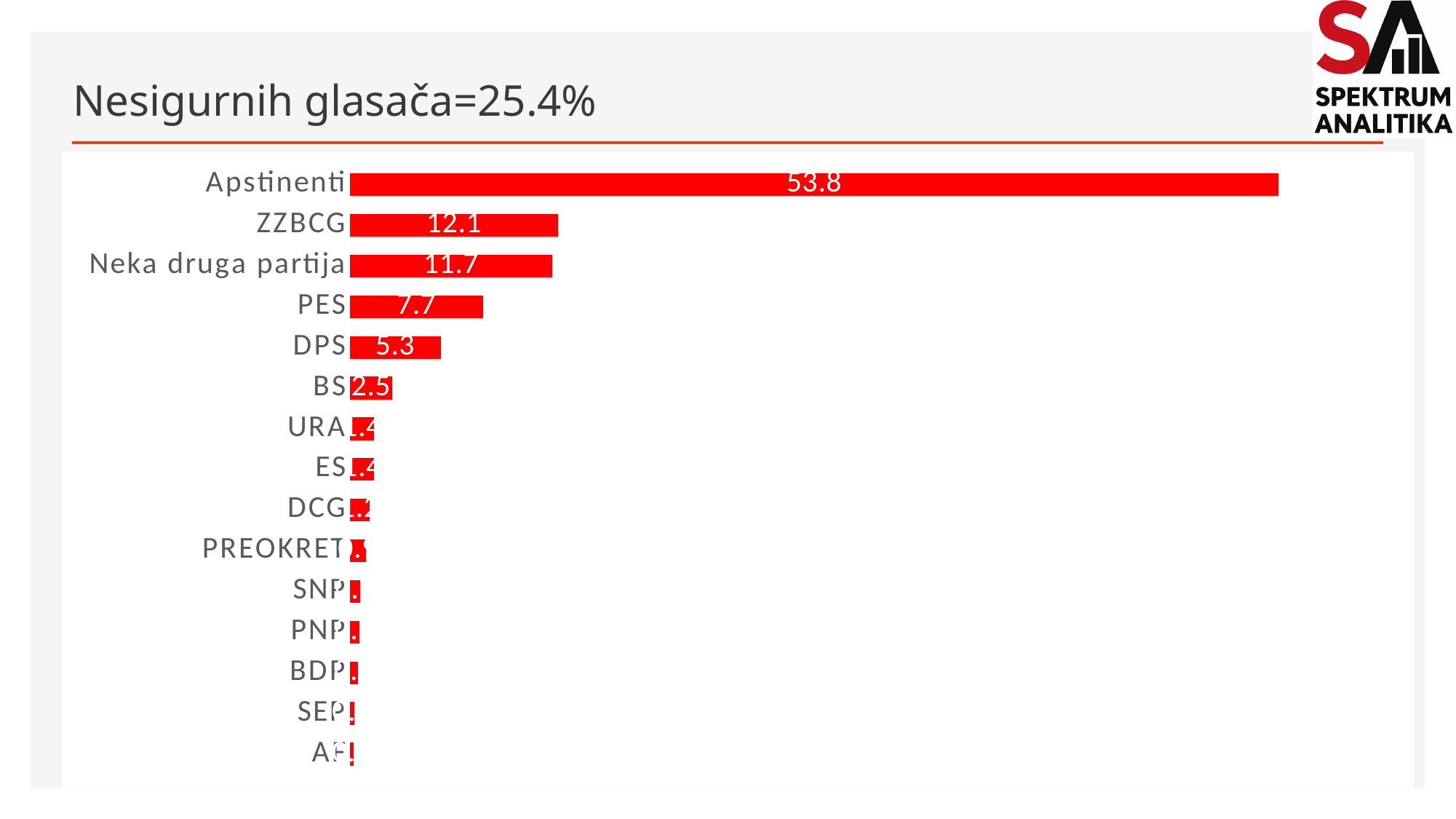
What is the value for DPS? 5.3 What is the value for PES? 7.7 What is the title of the slide? Nesigurnih glasača=25.4% What is the difference between the values for PES and DPS? 2.4 What is the difference between the values for Apstinenti and ZZBCG? 41.7 What is the value for Apstinenti? 53.8 What kind of chart is shown on the slide? bar chart What is the value for Neka druga partija? 11.7 What is the value for BS? 2.5 Which category has the highest value? Apstinenti What is the value for ZZBCG? 12.1 Which is larger, the value for ZZBCG or the value for Neka druga partija? ZZBCG